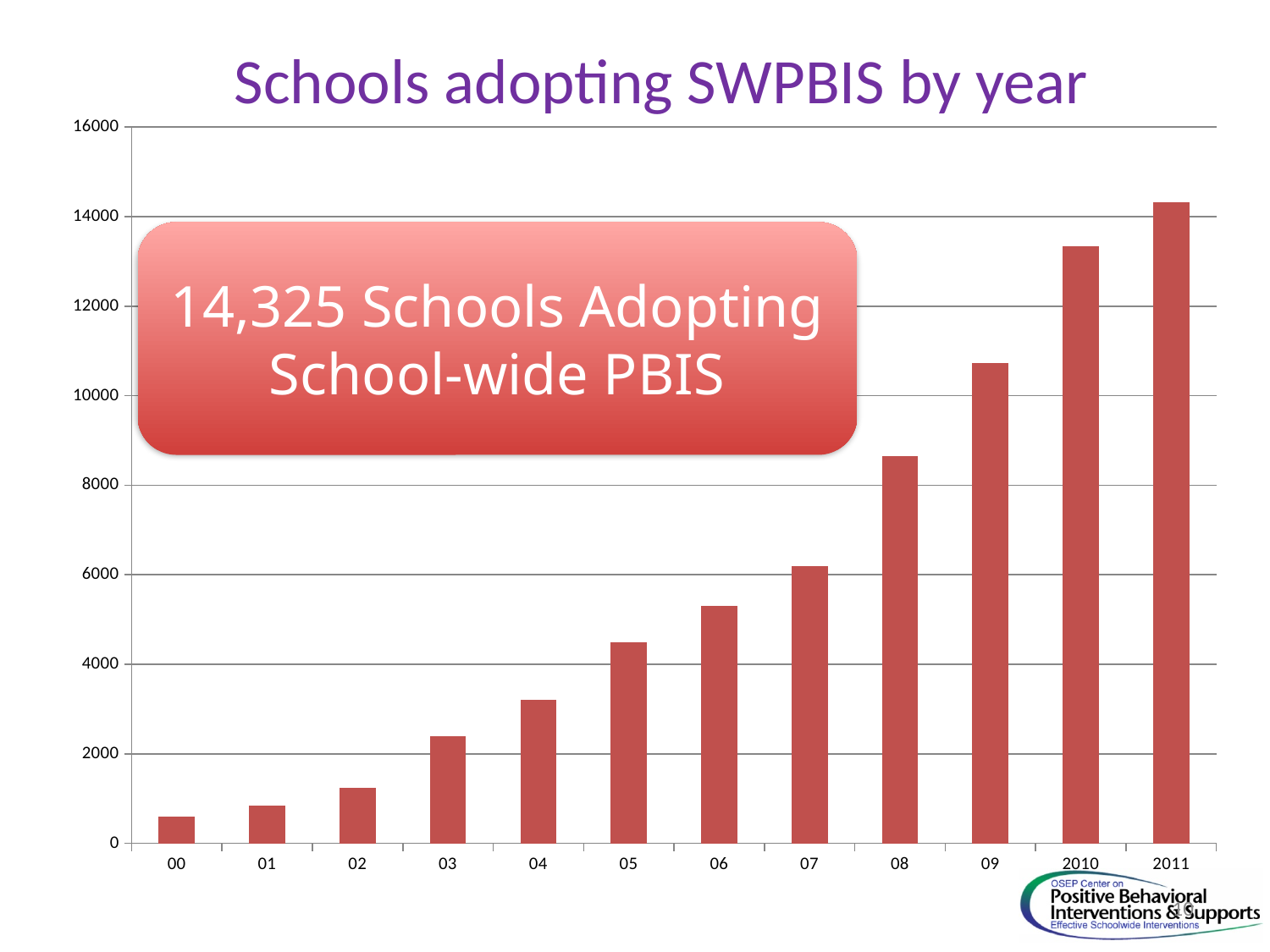
What is the title of the chart? Schools adopting SWPBIS by year According to the callout box on the chart, how many schools are adopting School-wide PBIS? 14,325 Is the value for 06 greater or less than 6000? less Which year has the highest number of schools adopting SWPBIS? 2011 Is the value for 2010 greater or less than 12000? greater Is the value for 04 greater or less than 4000? less How many years (bars) are shown on the x axis? 12 Do the values rise or fall from 00 to 2011? rise Which year has a larger value, 08 or 09? 09 What kind of chart is shown on the slide? bar chart Which year has the lowest number of schools adopting SWPBIS? 00